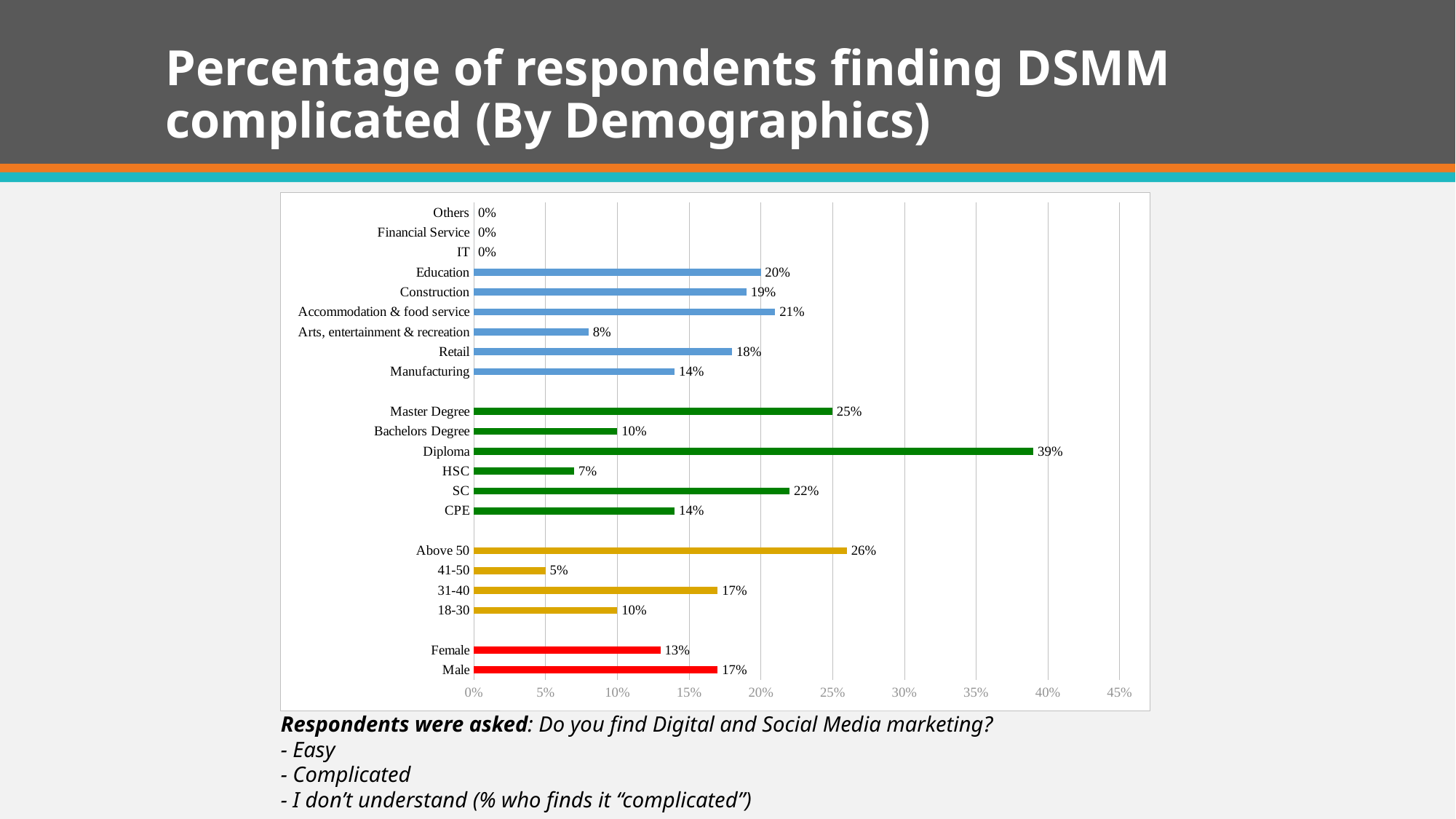
What colour are the bars for the education-level categories (Master Degree through CPE)? Green Which is larger, the value for Above 50 or the value for 31-40? Above 50 What is the difference between the values for Master Degree and Bachelors Degree? 15% What is the value shown for the Accommodation & food service category? 21% What is the value shown for Male respondents? 17% Among the age groups (18-30, 31-40, 41-50, Above 50), which has the lowest value? 41-50 How many categories show a value of 0%? 3 Which category has the highest value on the chart? Diploma What kind of chart is shown on the slide? Bar chart Which is larger, the value for Education or the value for Construction? Education What percentage of respondents with a Diploma find DSMM complicated? 39% What is the difference between the values for Male and Female respondents? 4%